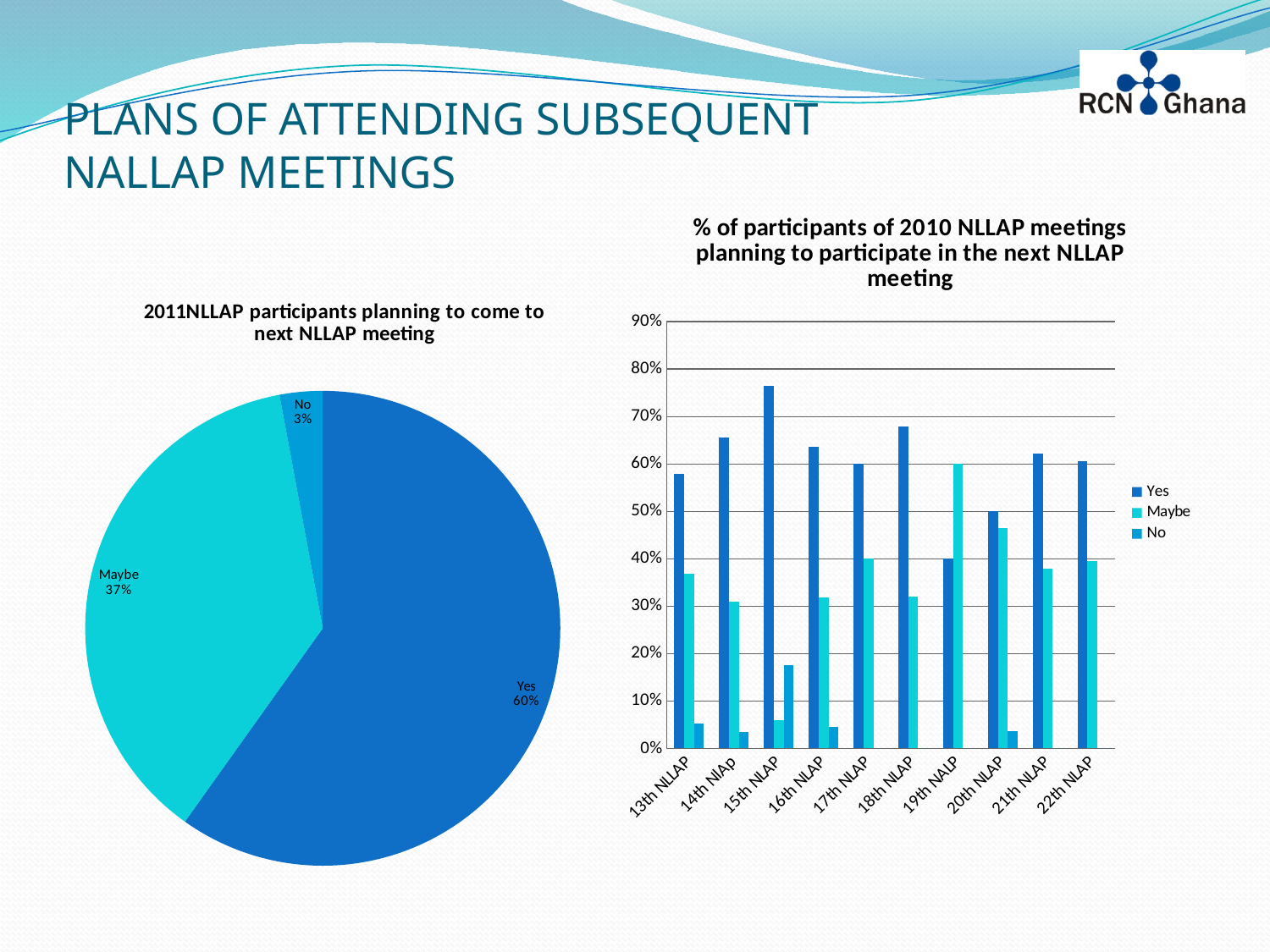
In the bar chart on the right, is the Yes value for 15th NLAP greater or less than 70%? greater In the pie chart on the left, what is the difference in percentage points between the Yes and Maybe slices? 23 What kind of chart is the chart on the right of the slide? Bar chart How many slices does the pie chart on the left have? 3 How many meetings are shown on the x axis of the bar chart on the right? 10 In the pie chart '2011NLLAP participants planning to come to next NLLAP meeting', what share of participants answered Maybe? 37% How many series does the legend of the bar chart on the right list? 3 In the pie chart on the left, which response has the largest slice? Yes In the pie chart '2011NLLAP participants planning to come to next NLLAP meeting', what share of participants answered No? 3% In the pie chart '2011NLLAP participants planning to come to next NLLAP meeting', what share of participants answered Yes? 60% In the bar chart on the right, which meeting has the highest Yes value? 15th NLAP In the bar chart on the right, for 19th NALP, which is larger: the Yes value or the Maybe value? Maybe